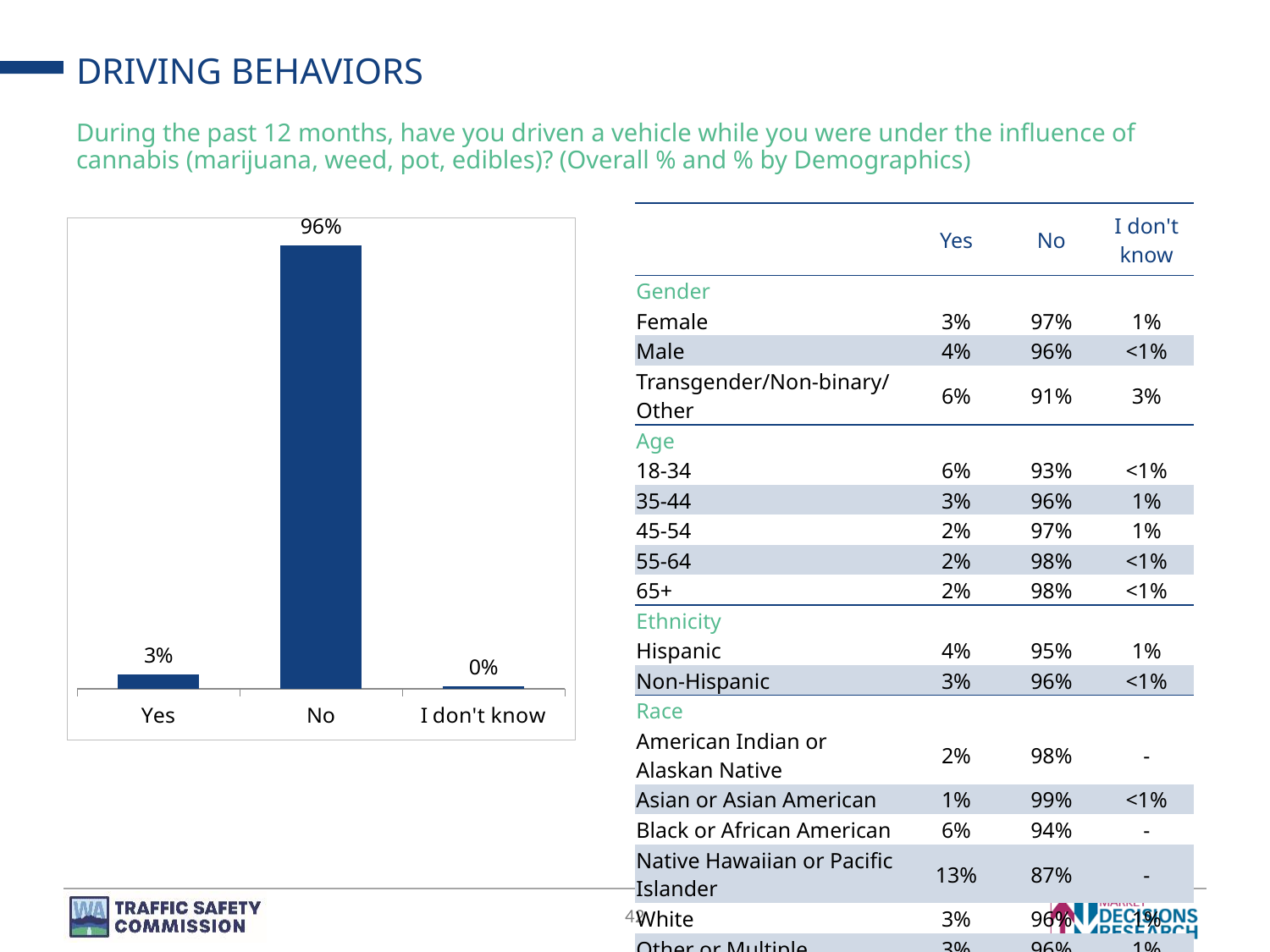
Which category has the lowest value in the chart? I don't know How many categories are shown on the x axis of the chart? 3 What is the difference between the "Yes" and "I don't know" values in the chart? 3% What is the value for the "Yes" bar in the chart? 3% What is the difference between the "No" and "Yes" values in the chart? 93% Which is larger in the chart, the value for "No" or the value for "Yes"? No Which is larger in the chart, the value for "Yes" or the value for "I don't know"? Yes Which category has the highest value in the chart? No What is the value for the "No" bar in the chart? 96% What is the label of the middle category on the x axis of the chart? No What is the value for the "I don't know" bar in the chart? 0% What kind of chart is shown on the slide? Bar chart